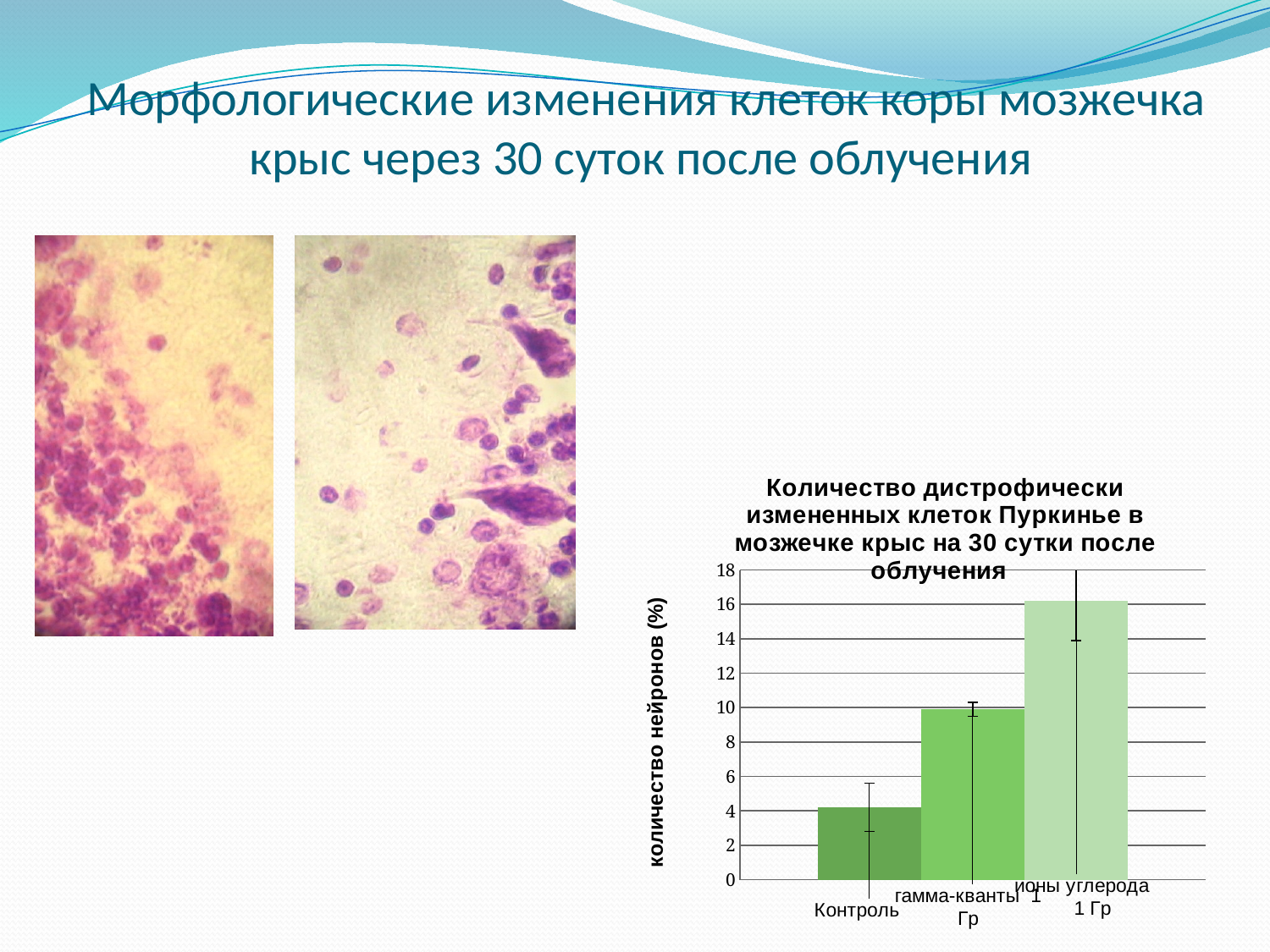
What is the highest tick value shown on the y axis of the chart? 18 How many categories are plotted on the x axis of the chart? 3 Which is larger, the value for гамма-кванты 1 Гр or the value for Контроль? гамма-кванты 1 Гр What is the label of the y axis of the chart? количество нейронов (%) Is the value for ионы углерода 1 Гр greater or less than 14? greater Which category has the lowest value in the chart? Контроль Is the value for Контроль greater or less than 6? less Do the bar values rise or fall from left to right along the x axis? rise Which category has the highest value in the chart? ионы углерода 1 Гр Is the value for гамма-кванты 1 Гр greater or less than 8? greater What kind of chart is shown on the slide? bar chart